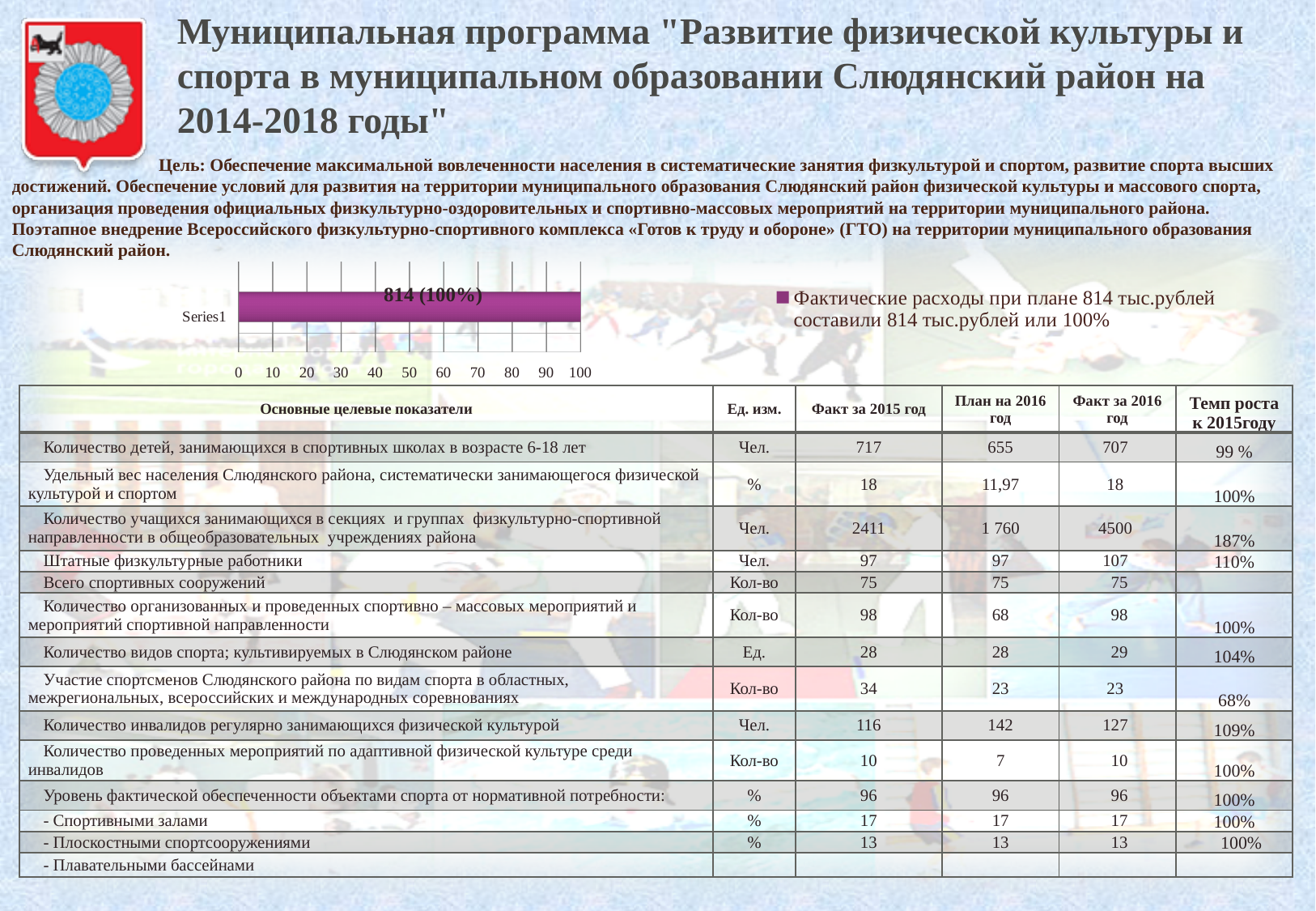
What colour is the bar in the chart? purple What kind of chart is shown on the slide? bar chart What is the data label printed on the bar in the chart? 814 (100%) What is the category label shown next to the bar in the chart? Series1 How many series does the chart legend list? 1 What is the lowest value shown on the x axis of the chart? 0 Is the bar for Series1 greater or less than 90 on the x axis? greater How many bars are plotted in the chart? 1 What is the highest value shown on the x axis of the chart? 100